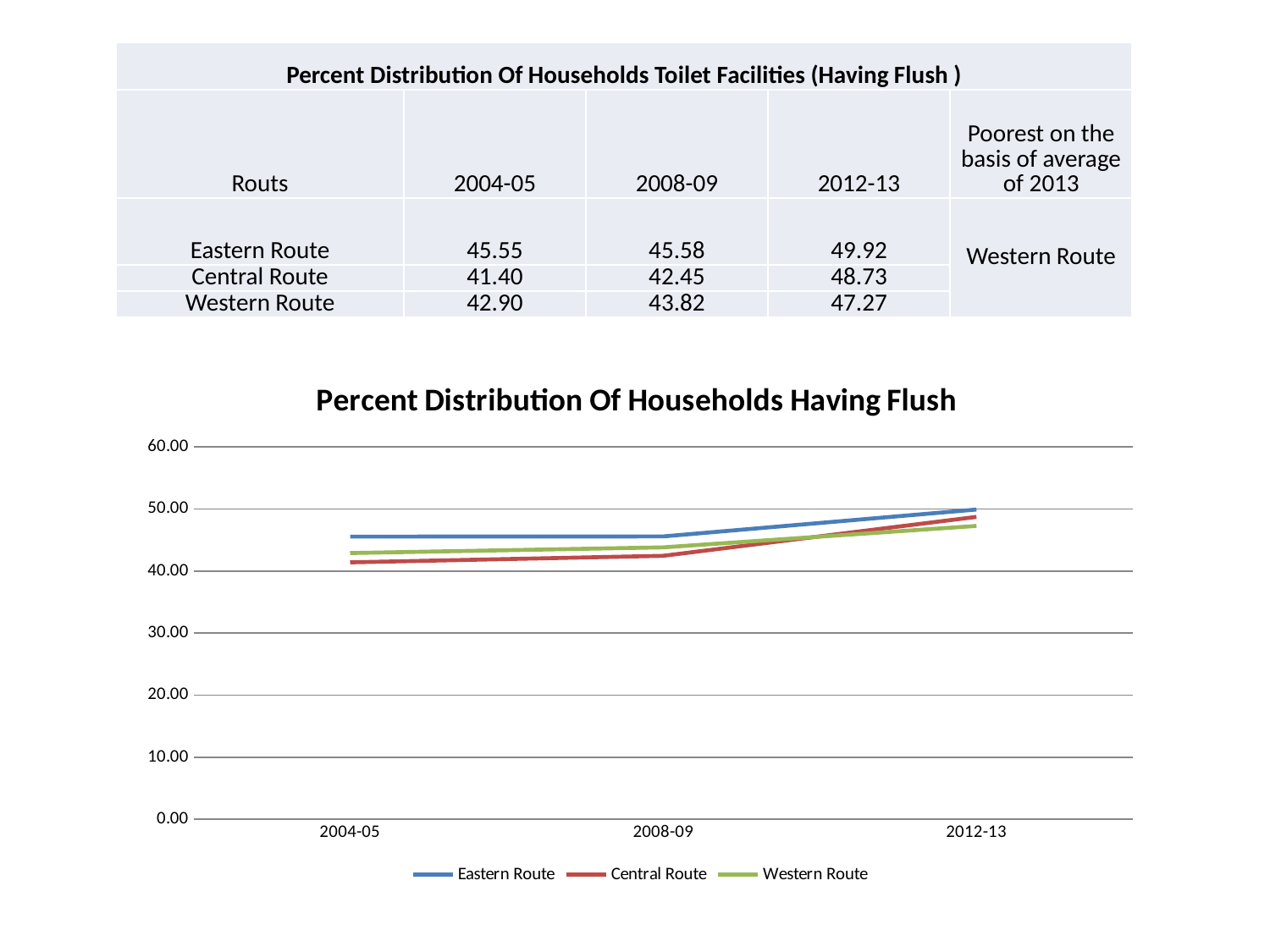
Which route has the highest value in 2004-05? Eastern Route How many time periods are shown on the x axis of the chart? 3 Which route has the lowest value in 2004-05? Central Route What is the title of the chart? Percent Distribution Of Households Having Flush What is the value for Western Route in 2008-09? 43.82 What kind of chart is shown on the slide? line chart How many series does the chart legend list? 3 What is the value for Eastern Route in 2012-13? 49.92 Is the value for Eastern Route in 2008-09 greater or less than 40.00? greater What is the difference between the Eastern Route and Western Route values in 2012-13? 2.65 What is the value for Central Route in 2004-05? 41.40 Does the Central Route line rise or fall from 2004-05 to 2012-13? rise